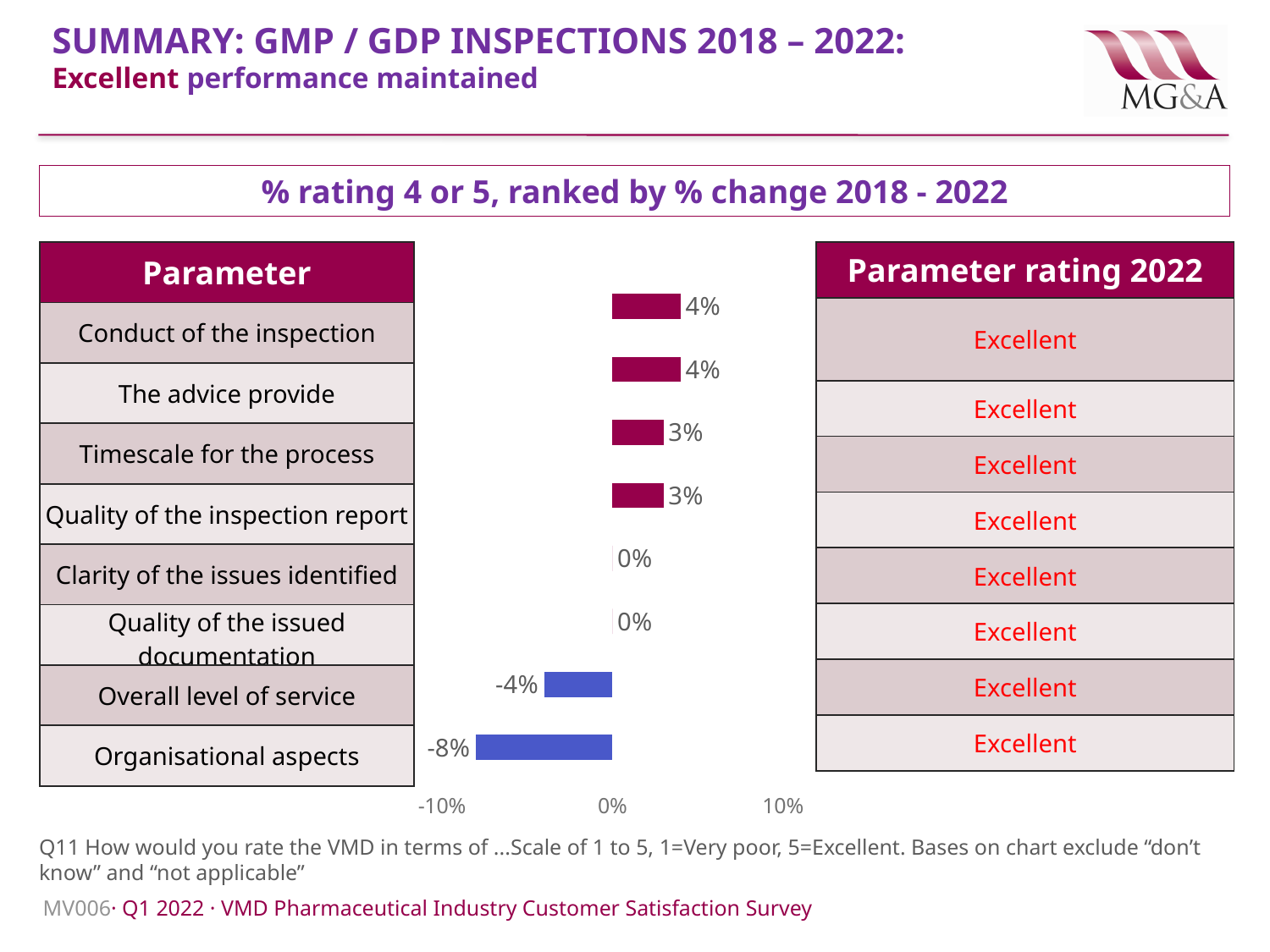
Which parameter has the lowest % change 2018 - 2022? Organisational aspects What is the % change 2018 - 2022 for Conduct of the inspection? 4% What is the % change 2018 - 2022 for Clarity of the issues identified? 0% What is the % change 2018 - 2022 for Overall level of service? -4% How many parameters are plotted in the chart? 8 What is the title of the chart? % rating 4 or 5, ranked by % change 2018 - 2022 What is the % change 2018 - 2022 for Organisational aspects? -8% Which has a larger % change 2018 - 2022: Quality of the inspection report or Overall level of service? Quality of the inspection report What is the % change 2018 - 2022 for Timescale for the process? 3% What kind of chart is shown on the slide? Bar chart What is the difference between the % change for Conduct of the inspection and Organisational aspects? 12 percentage points How many parameters show a negative % change 2018 - 2022? 2